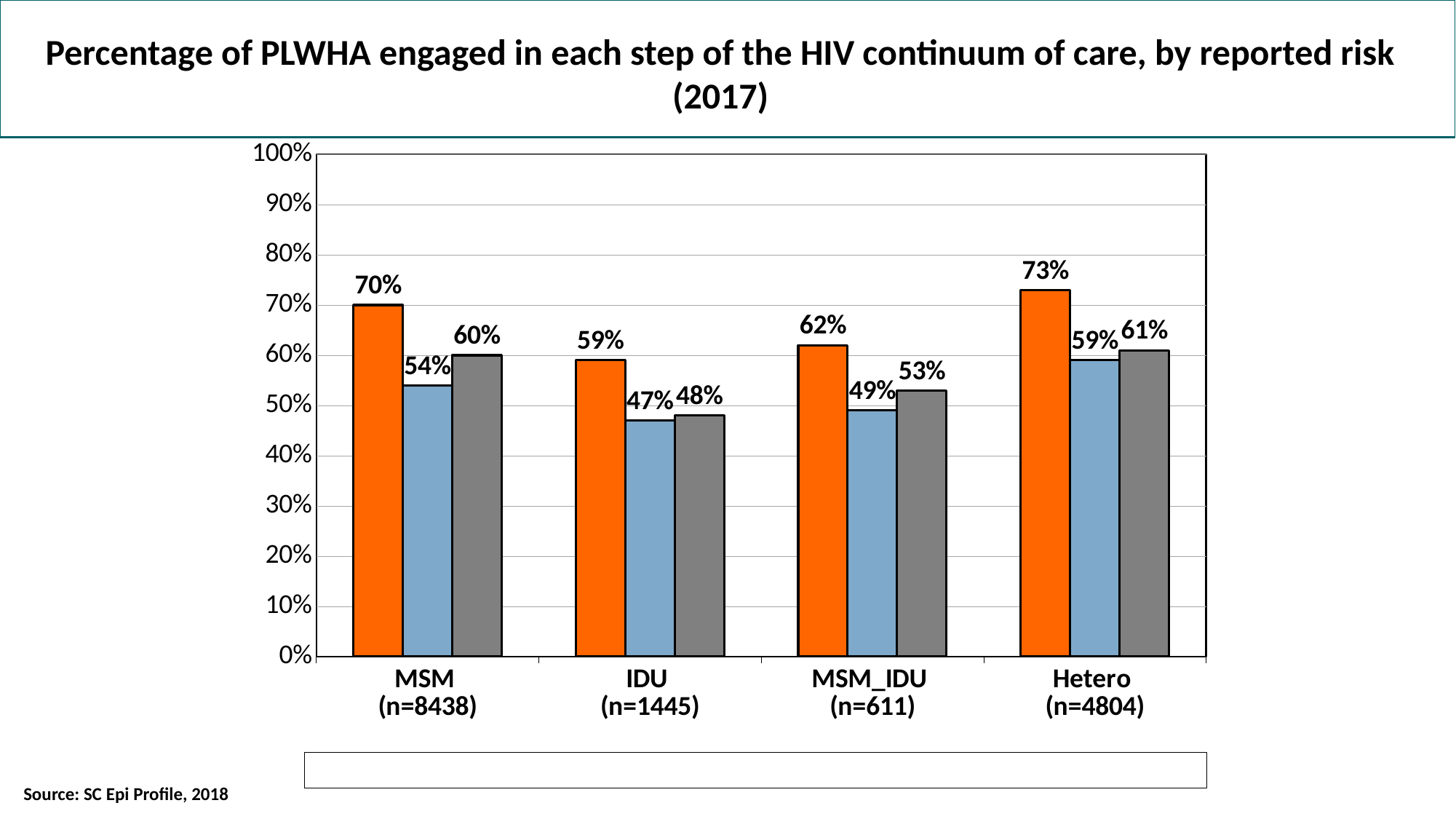
What is the title of the chart? Percentage of PLWHA engaged in each step of the HIV continuum of care, by reported risk (2017) What is the value of the blue bar for IDU (n=1445)? 47% Is the value of the orange bar for IDU (n=1445) greater or less than 50%? greater Which risk category has the highest orange bar? Hetero (n=4804) What is the value of the orange bar for Hetero (n=4804)? 73% What kind of chart is shown on the slide? bar chart How many risk categories are shown on the x axis? 4 Which risk category has the lowest blue bar? IDU (n=1445) Which is larger, the grey bar for MSM (n=8438) or the grey bar for Hetero (n=4804)? Hetero (n=4804) What is the value of the orange bar for MSM (n=8438)? 70% What is the value of the grey bar for MSM_IDU (n=611)? 53% What is the difference between the orange bar and the blue bar for MSM (n=8438)? 16%